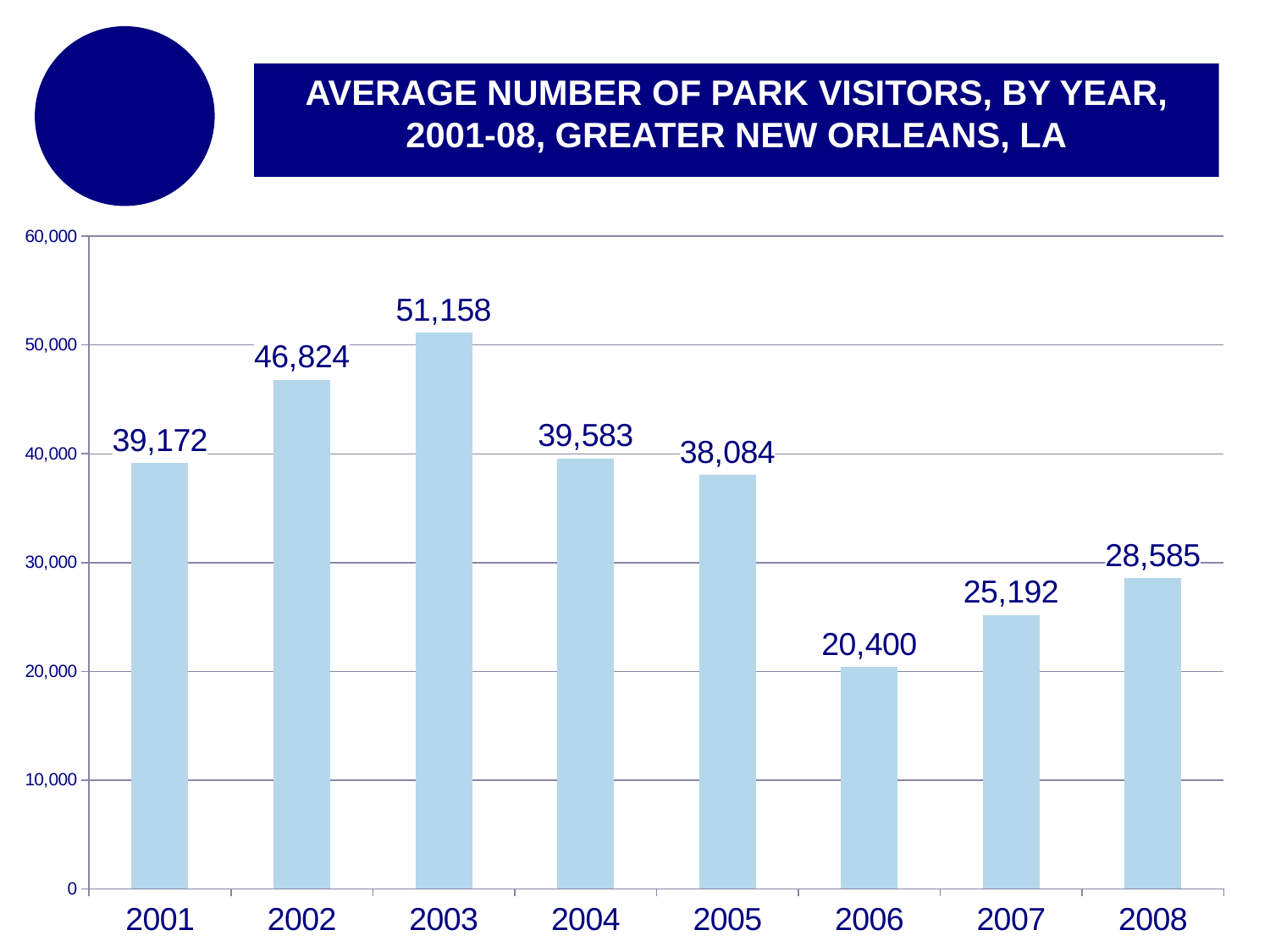
Is the value for 2007 greater or less than 30,000? less What kind of chart is shown on the slide? Bar chart What is the average number of park visitors in 2003? 51,158 Which year had more park visitors on average, 2004 or 2005? 2004 What is the average number of park visitors in 2008? 28,585 What is the average number of park visitors in 2006? 20,400 How many years are shown on the chart? 8 What is the title of the chart? AVERAGE NUMBER OF PARK VISITORS, BY YEAR, 2001-08, GREATER NEW ORLEANS, LA What is the difference between the average number of park visitors in 2003 and 2006? 30,758 Which year has the lowest average number of park visitors? 2006 What is the difference between the average number of park visitors in 2002 and 2001? 7,652 Which year has the highest average number of park visitors? 2003